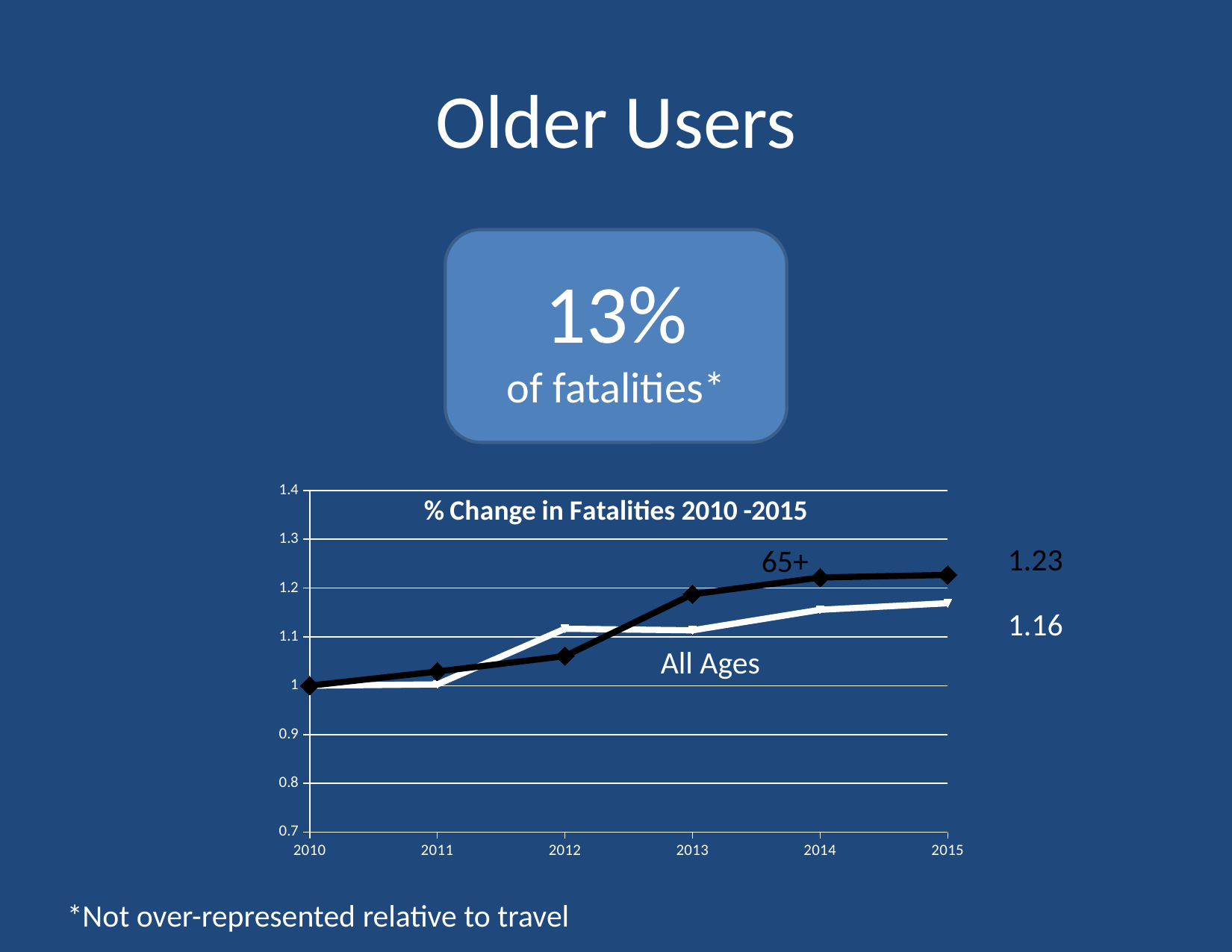
In 2012, which series has the higher value, 65+ or All Ages? All Ages Does the 65+ series rise or fall from 2010 to 2015? rise In 2015, which series has the higher value, 65+ or All Ages? 65+ How many years are plotted on the x axis? 6 What is the title of the chart? % Change in Fatalities 2010 -2015 How many series are plotted on the chart? 2 What is the difference between the 65+ value and the All Ages value in 2015? 0.07 What kind of chart is shown on the slide? line chart What is the value for the 65+ series in 2015? 1.23 Is the value for 65+ in 2012 greater or less than 1.1? less What is the value for the All Ages series in 2015? 1.16 Is the value for 65+ in 2013 greater or less than 1.1? greater